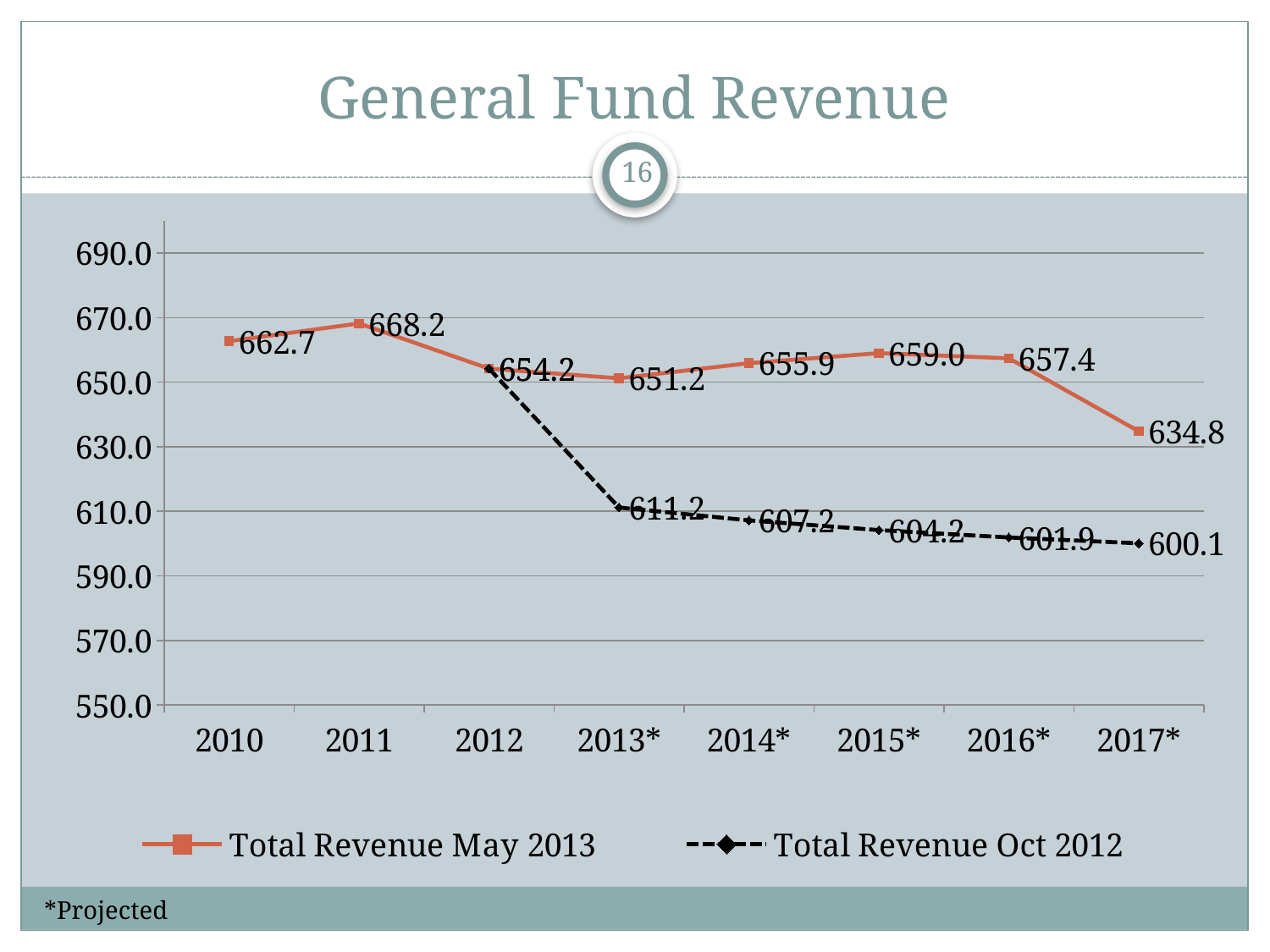
What is the difference between the Total Revenue May 2013 and Total Revenue Oct 2012 values for 2013*? 40.0 What is the Total Revenue May 2013 value for 2011? 668.2 What is the title of the chart? General Fund Revenue How many series does the legend list? 2 What is the Total Revenue May 2013 value for 2017*? 634.8 What type of chart is shown on the slide? line chart Does the Total Revenue Oct 2012 series rise or fall from 2013* to 2017*? fall What is the Total Revenue Oct 2012 value for 2017*? 600.1 In which year is the Total Revenue May 2013 series lowest? 2017* How many years are shown on the x axis? 8 Which is larger for 2015*: Total Revenue May 2013 or Total Revenue Oct 2012? Total Revenue May 2013 In which year is the Total Revenue May 2013 series highest? 2011